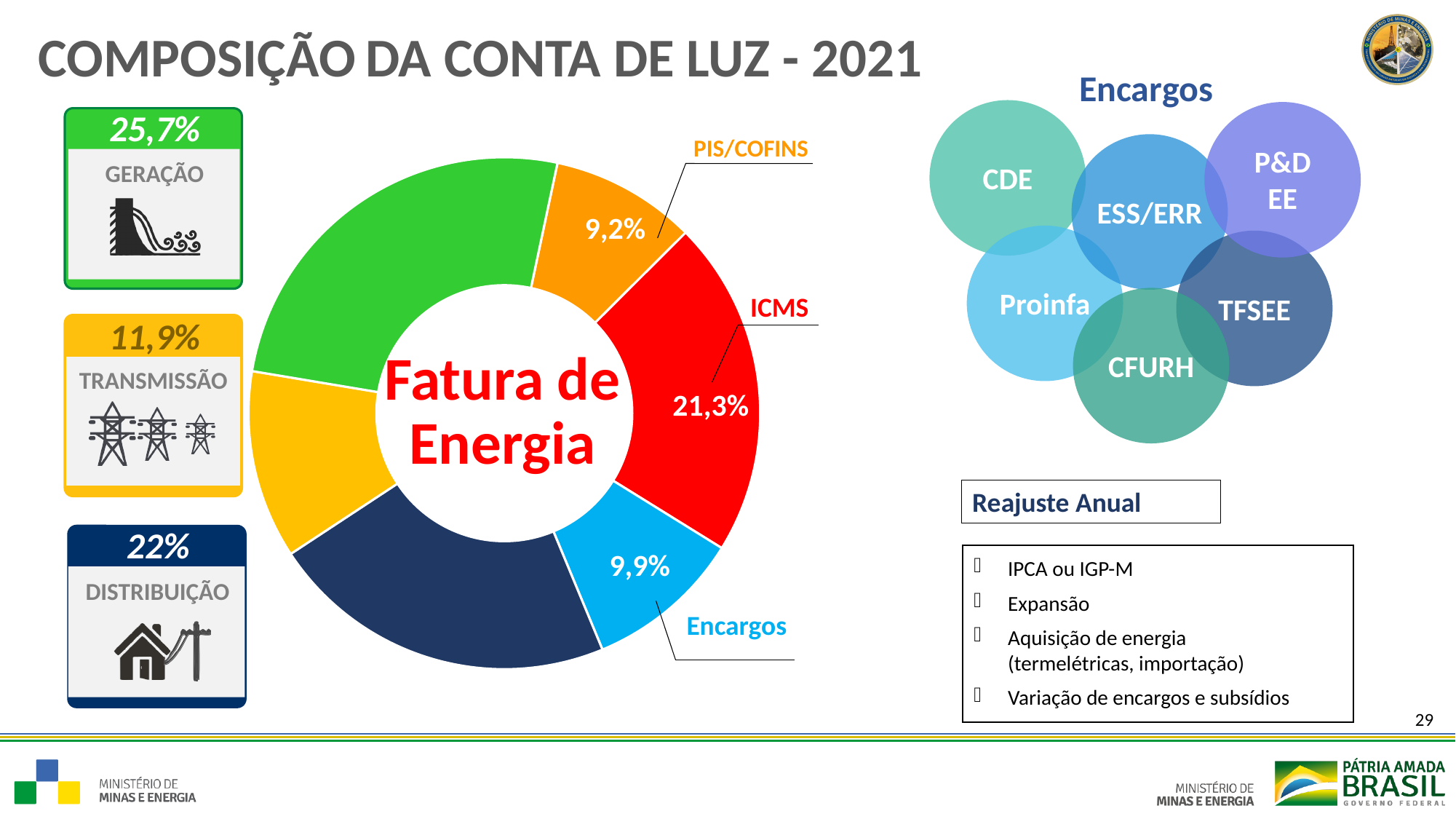
What kind of chart is shown on the slide? Pie chart (donut) Which component has the largest share of the Fatura de Energia? Geração (25,7%) What percentage does the ICMS slice represent in the Fatura de Energia chart? 21,3% What text appears in the centre of the donut chart? Fatura de Energia How many slices does the Fatura de Energia donut chart have? 6 Which component has the smallest share of the Fatura de Energia? PIS/COFINS (9,2%) What share of the bill is attributed to Geração? 25,7% What percentage does the PIS/COFINS slice represent? 9,2% What is the difference between the ICMS share and the PIS/COFINS share? 12,1 percentage points What share of the bill is attributed to Transmissão? 11,9% What share of the bill is attributed to Distribuição? 22% What percentage does the Encargos slice represent? 9,9%